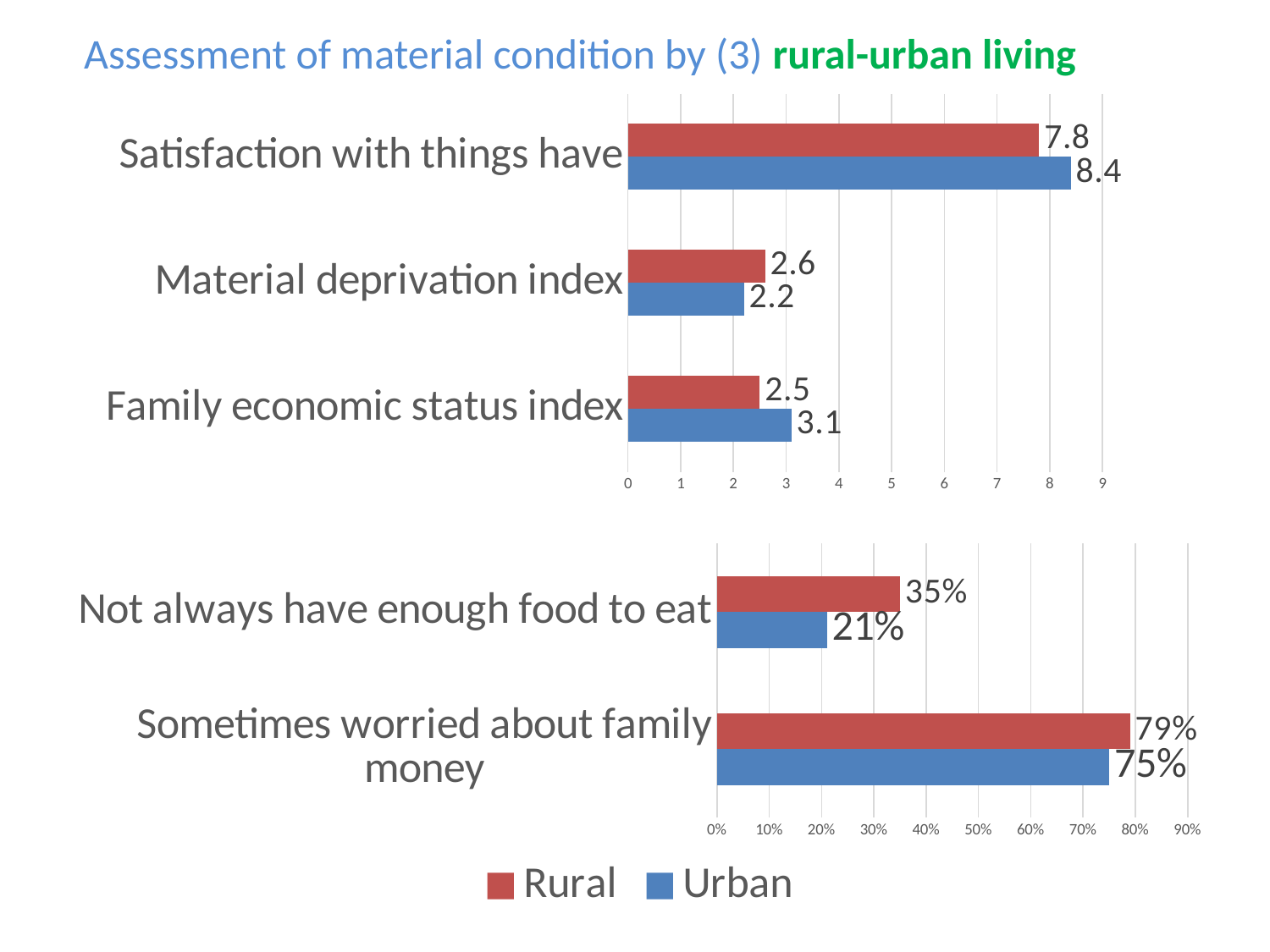
In the bottom chart, which is larger for Sometimes worried about family money, Rural or Urban? Rural In the bottom chart, what is the difference between the Rural and Urban values for Not always have enough food to eat? 14% How many categories does the top chart show? 3 What type of chart is the bottom chart? Bar chart In the bottom chart, what is the Urban value for Sometimes worried about family money? 75% In the top chart, which category has the lowest Urban value? Material deprivation index In the bottom chart, what is the Rural value for Not always have enough food to eat? 35% In the top chart, what is the difference between the Urban and Rural values for Family economic status index? 0.6 How many series does the legend list? 2 In the top chart, which category has the highest Rural value? Satisfaction with things have In the top chart, what is the Rural value for Material deprivation index? 2.6 In the top chart, what is the Urban value for Satisfaction with things have? 8.4